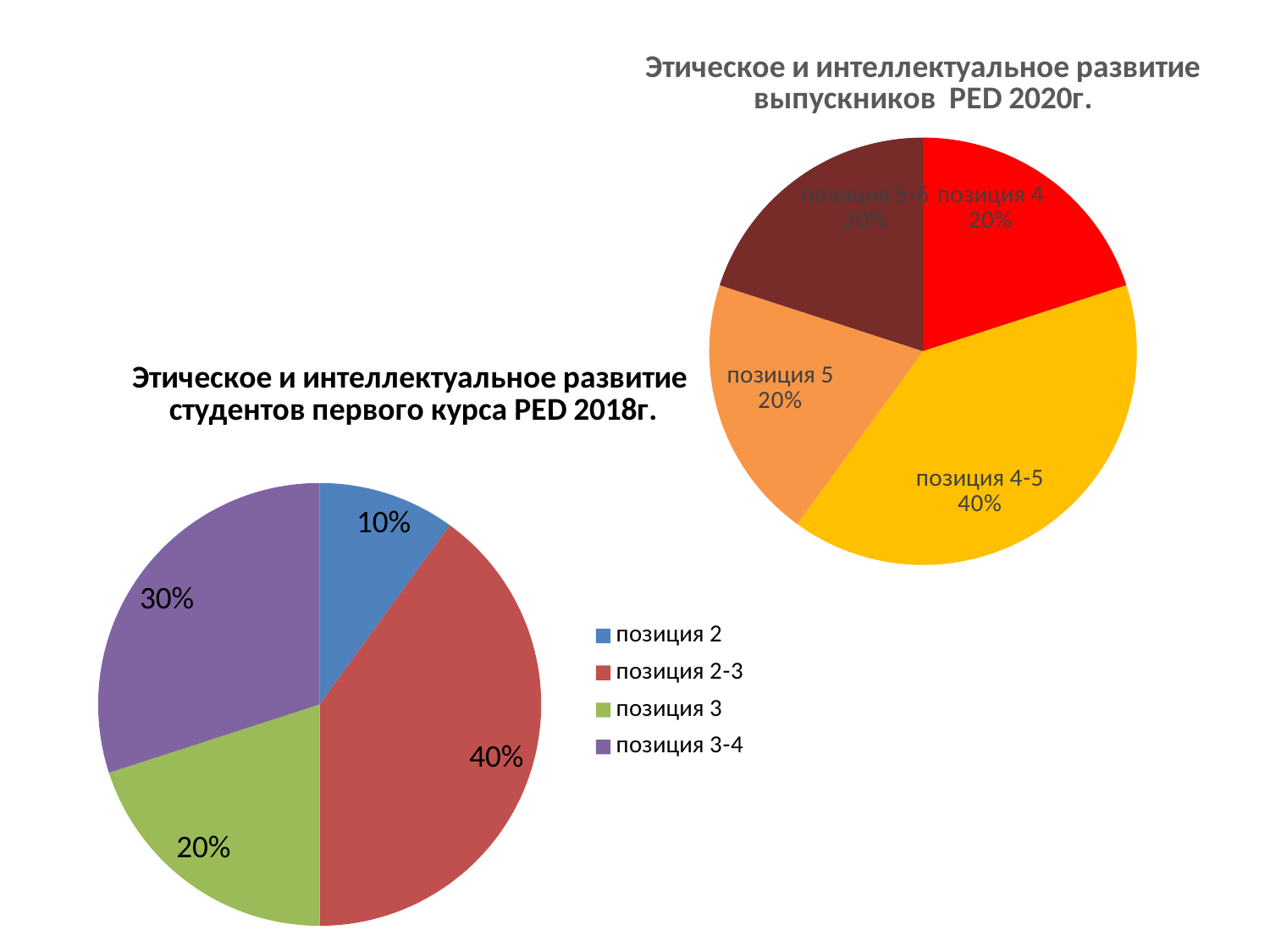
In the 2020 chart (graduates, "выпускников PED 2020г."), which category has the largest slice? позиция 4-5 What kind of chart is the 2018 chart ("Этическое и интеллектуальное развитие студентов первого курса PED 2018г.")? pie chart In the 2018 chart (students of the first course), how many categories does the legend list? 4 In the 2018 chart (students of the first course), which category has the smallest slice? позиция 2 In the 2020 chart (graduates, "выпускников PED 2020г."), what share does "позиция 5" have? 20% In the 2018 chart (students of the first course), which category has the largest slice? позиция 2-3 In the 2018 chart (students of the first course), what share does "позиция 2-3" have? 40% In the 2018 chart (students of the first course), what share does "позиция 2" have? 10% In the 2018 chart (students of the first course), what is the difference between the shares of "позиция 3-4" and "позиция 3"? 10% In the 2018 chart (students of the first course), which colour represents "позиция 3"? green